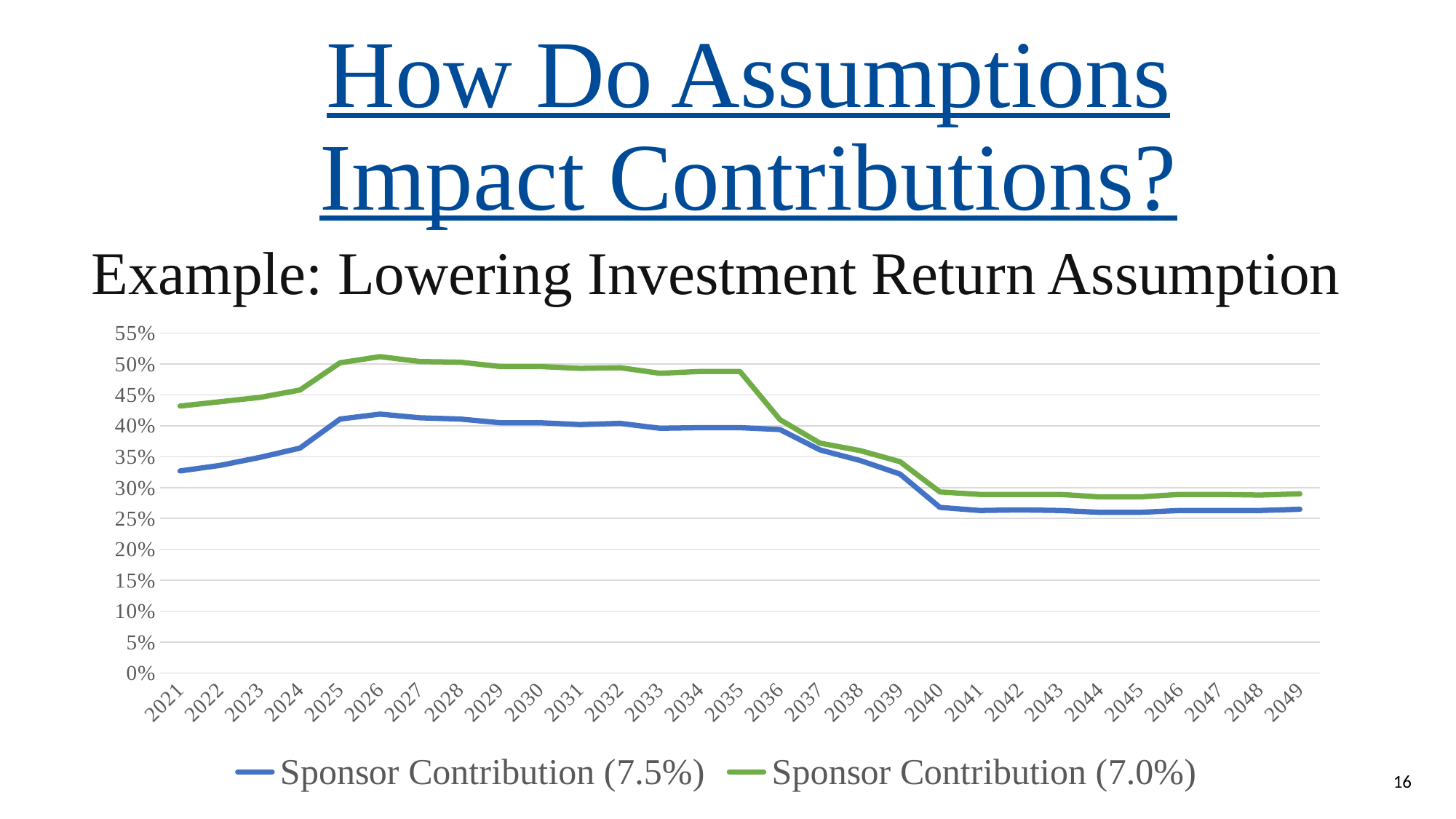
Is the value for Sponsor Contribution (7.0%) in 2026 greater or less than 50%? greater How many series does the legend list? 2 Which series has the higher value in 2030, Sponsor Contribution (7.5%) or Sponsor Contribution (7.0%)? Sponsor Contribution (7.0%) How many years are plotted along the x axis? 29 Which colour is used for the Sponsor Contribution (7.5%) line? blue What is the first year shown on the x axis? 2021 Is the value for Sponsor Contribution (7.5%) in 2049 greater or less than 30%? less Is the value for Sponsor Contribution (7.0%) in 2021 greater or less than 40%? greater Do the values for Sponsor Contribution (7.0%) rise or fall between 2035 and 2040? fall What kind of chart is shown on the slide? line chart In which year does Sponsor Contribution (7.0%) reach its highest value? 2026